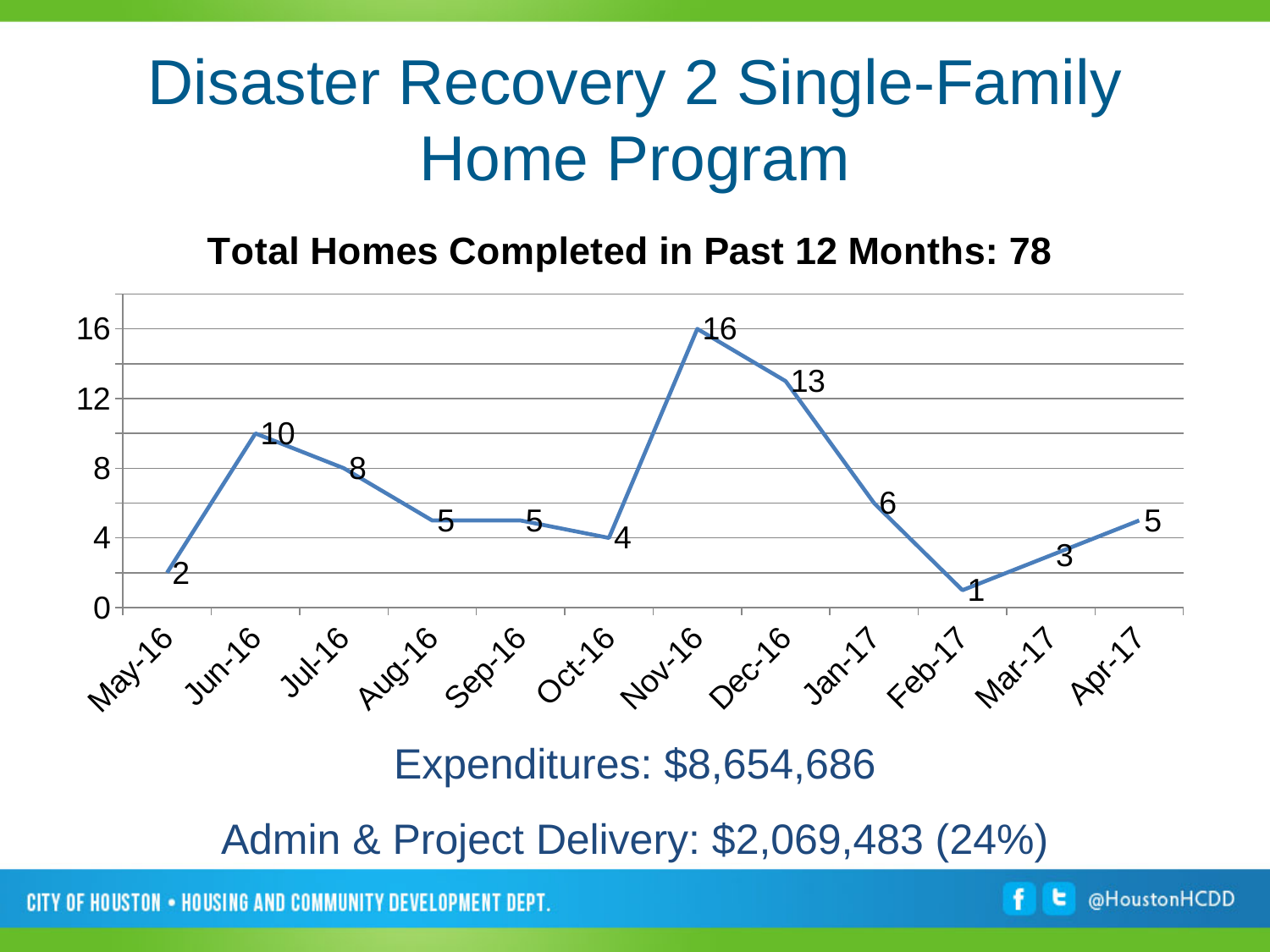
What is the value for Feb-17? 1 What kind of chart is shown? Line chart Is the value for Dec-16 greater or less than 12? greater What is the value for Jun-16? 10 Which is larger, the value for Jul-16 or the value for Jan-17? Jul-16 Which month has the lowest value? Feb-17 What is the title of the chart? Total Homes Completed in Past 12 Months: 78 How many months are plotted on the x axis? 12 What is the difference between the values for Nov-16 and Dec-16? 3 Do the values rise or fall from Nov-16 to Feb-17? Fall How many homes were completed in Nov-16? 16 Which month has the highest value? Nov-16